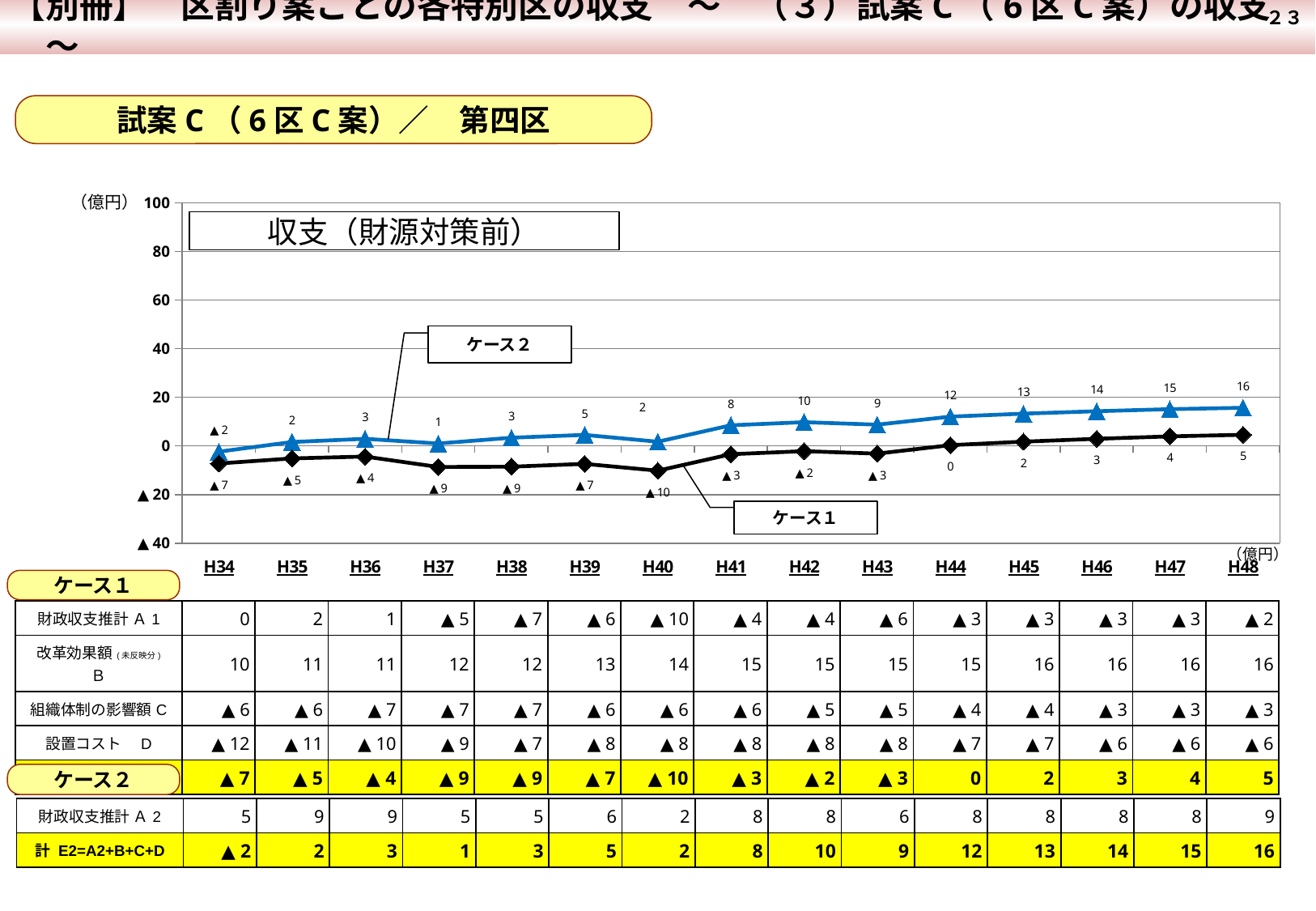
What is the difference between ケース2 and ケース1 at H48? 11 What is the value of ケース2 at H48? 16 In which year does ケース1 reach its lowest value? H40 Is the value of ケース2 at H48 greater or less than 20? less How many fiscal years (x-axis points) are plotted in the chart? 15 In which year does ケース2 reach its highest value? H48 What is the value of ケース1 at H40? ▲10 How many series are plotted in the chart 収支（財源対策前）? 2 Which series has the larger value at H44, ケース1 or ケース2? ケース2 Does ケース2 rise or fall from H41 to H48? rise What type of chart is shown on the slide? line chart What is the value of ケース2 at H42? 10